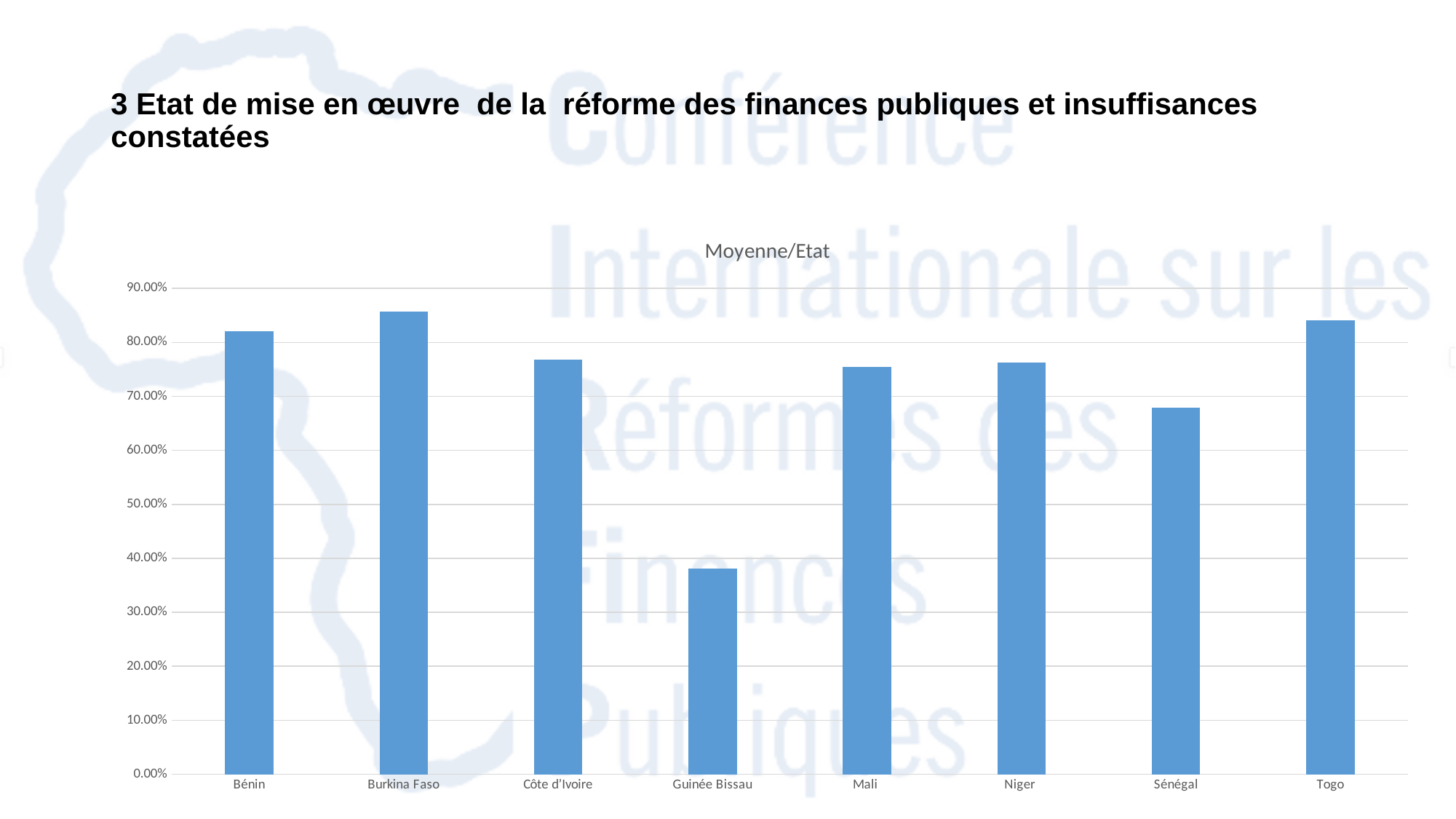
Is the value for Mali greater or less than 80.00%? less What is the title of the chart? Moyenne/Etat Which has the larger value, Bénin or Sénégal? Bénin Is the value for Guinée Bissau greater or less than 30.00%? greater Is the value for Togo greater or less than 80.00%? greater What kind of chart is shown on the slide? Bar chart Which has the larger value, Côte d'Ivoire or Guinée Bissau? Côte d'Ivoire Which country has the lowest value in the chart? Guinée Bissau Which country has the highest value in the chart? Burkina Faso How many countries are shown on the x axis of the chart? 8